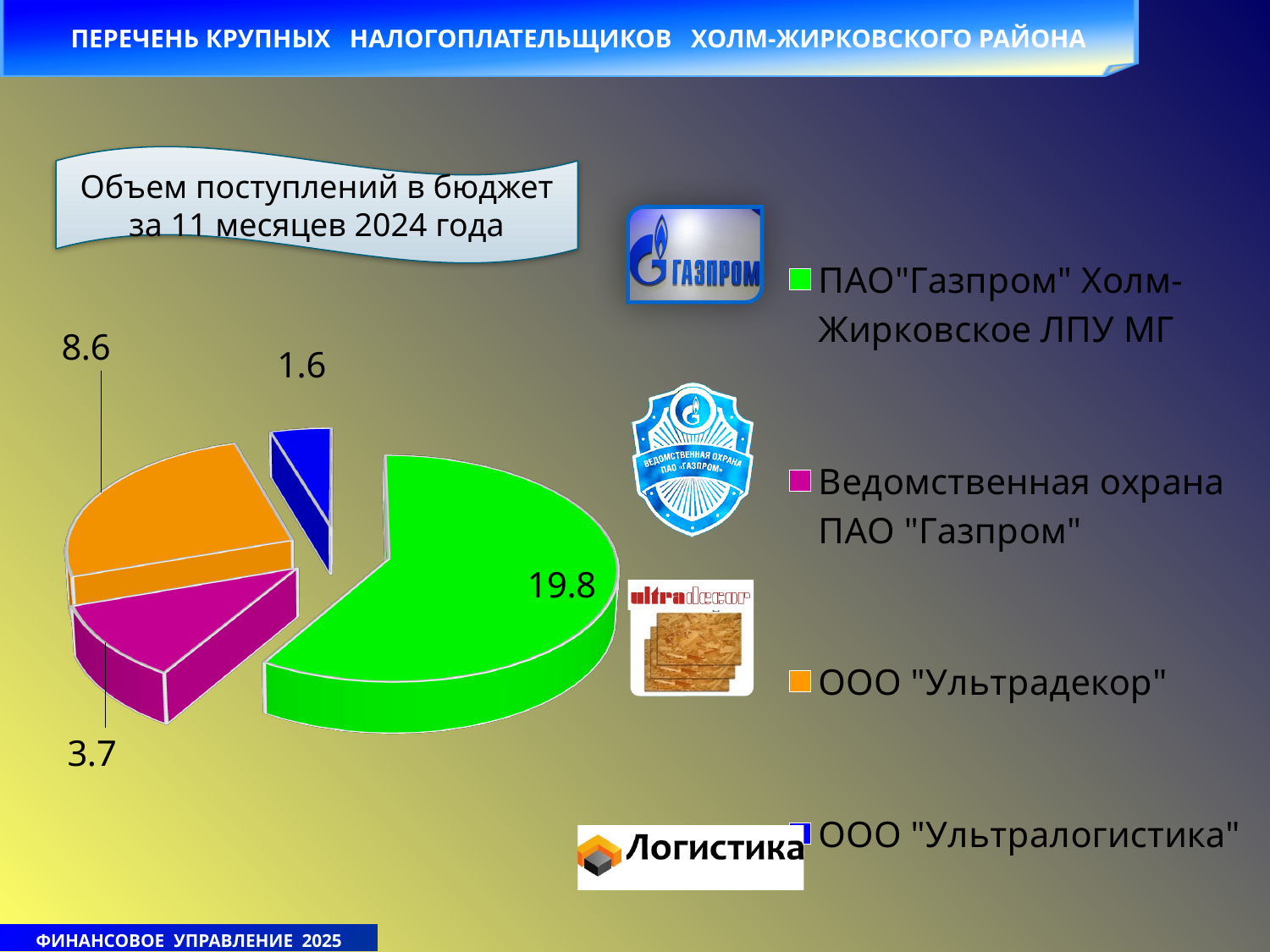
How many entries does the legend list? 4 Which taxpayer has the smallest slice of the pie? ООО "Ультралогистика" Which is larger: the value for ООО "Ультрадекор" or the value for Ведомственная охрана ПАО "Газпром"? ООО "Ультрадекор" What is the difference between the values for ПАО "Газпром" Холм-Жирковское ЛПУ МГ and ООО "Ультрадекор"? 11.2 Which taxpayer has the largest slice of the pie? ПАО "Газпром" Холм-Жирковское ЛПУ МГ How many slices does the pie chart have? 4 What is the value for Ведомственная охрана ПАО "Газпром"? 3.7 What colour is the slice for ООО "Ультрадекор"? Orange What is the value for ООО "Ультралогистика"? 1.6 What is the value for ПАО "Газпром" Холм-Жирковское ЛПУ МГ? 19.8 What is the value for ООО "Ультрадекор"? 8.6 What type of chart is shown on the slide? Pie chart